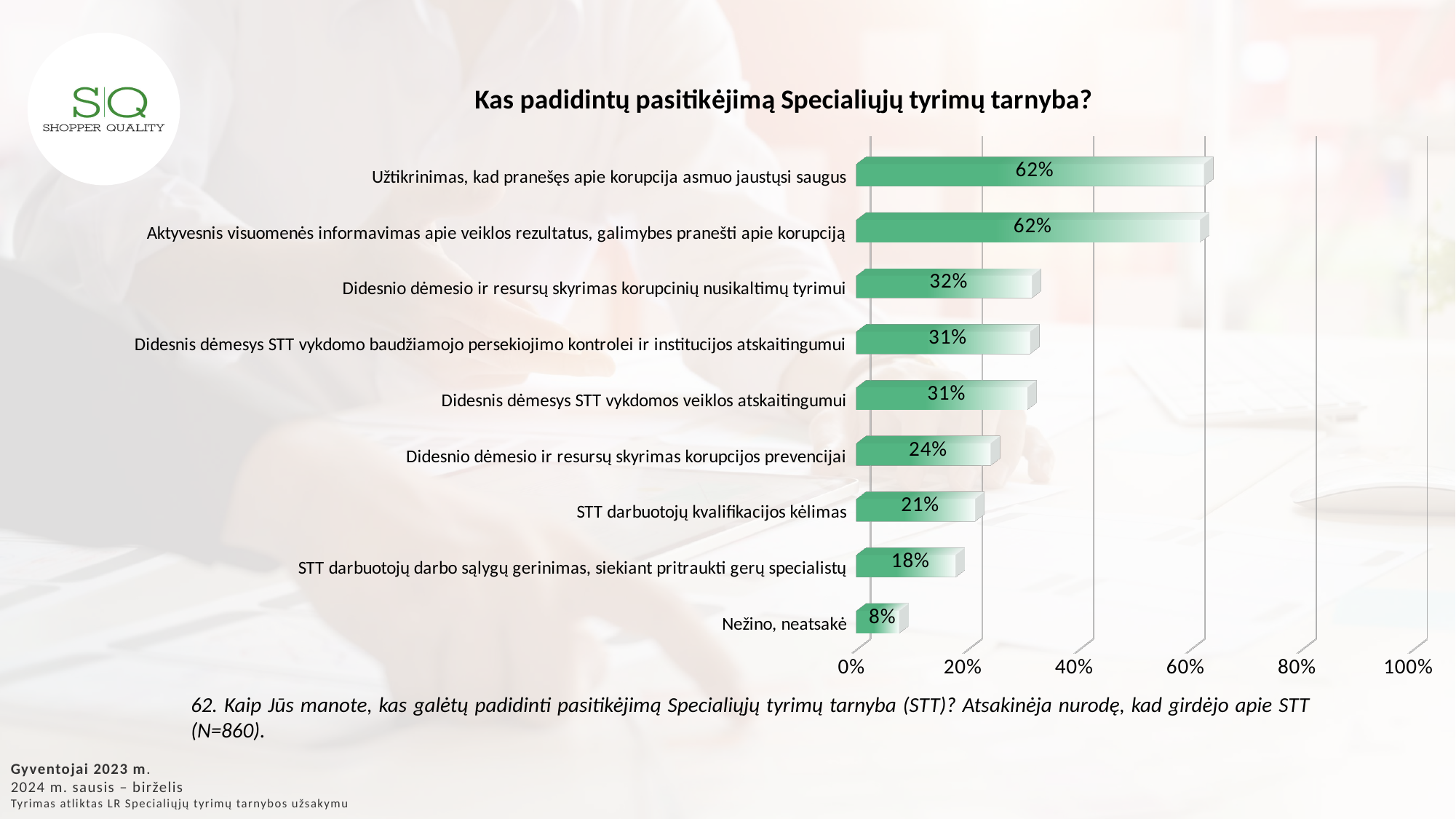
Which is larger: the value for "Didesnio dėmesio ir resursų skyrimas korupcijos prevencijai" or the value for "STT darbuotojų darbo sąlygų gerinimas, siekiant pritraukti gerų specialistų"? Didesnio dėmesio ir resursų skyrimas korupcijos prevencijai What is the value for "Nežino, neatsakė"? 8% What is the value for "Didesnio dėmesio ir resursų skyrimas korupcinių nusikaltimų tyrimui"? 32% Which category has the lowest value? Nežino, neatsakė What is the difference between the values for "STT darbuotojų kvalifikacijos kėlimas" and "STT darbuotojų darbo sąlygų gerinimas, siekiant pritraukti gerų specialistų"? 3% How many categories are shown in the chart? 9 Is the value for "Aktyvesnis visuomenės informavimas apie veiklos rezultatus, galimybes pranešti apie korupciją" greater or less than 60%? greater What is the title of the chart? Kas padidintų pasitikėjimą Specialiųjų tyrimų tarnyba? What kind of chart is shown on the slide? bar chart What is the difference between the values for "Užtikrinimas, kad pranešęs apie korupcija asmuo jaustųsi saugus" and "Didesnio dėmesio ir resursų skyrimas korupcinių nusikaltimų tyrimui"? 30% What is the value for "STT darbuotojų kvalifikacijos kėlimas"? 21% What is the value for "Didesnio dėmesio ir resursų skyrimas korupcijos prevencijai"? 24%